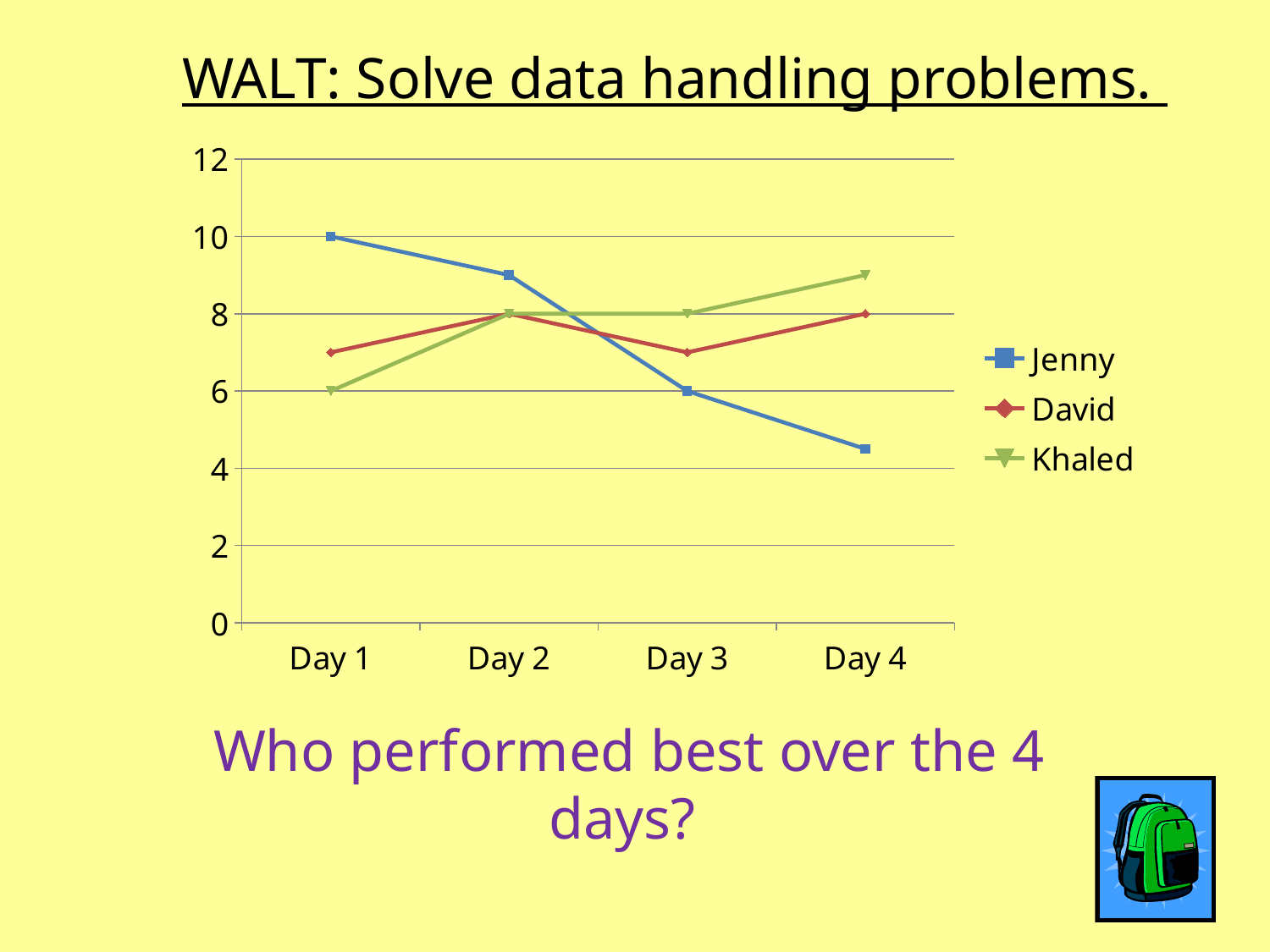
What is the difference between Jenny's value on Day 1 and her value on Day 3? 4 Who has the highest value on Day 1? Jenny What is Khaled's value on Day 1? 6 Is Jenny's value on Day 4 greater or less than 6? less What is Jenny's value on Day 1? 10 How many series does the legend list? 3 How many days are shown on the x axis? 4 Does Jenny's line rise or fall from Day 1 to Day 4? Fall What is David's value on Day 4? 8 What type of chart is shown on the slide? Line chart Which series is shown in green? Khaled Who has the lowest value on Day 4? Jenny